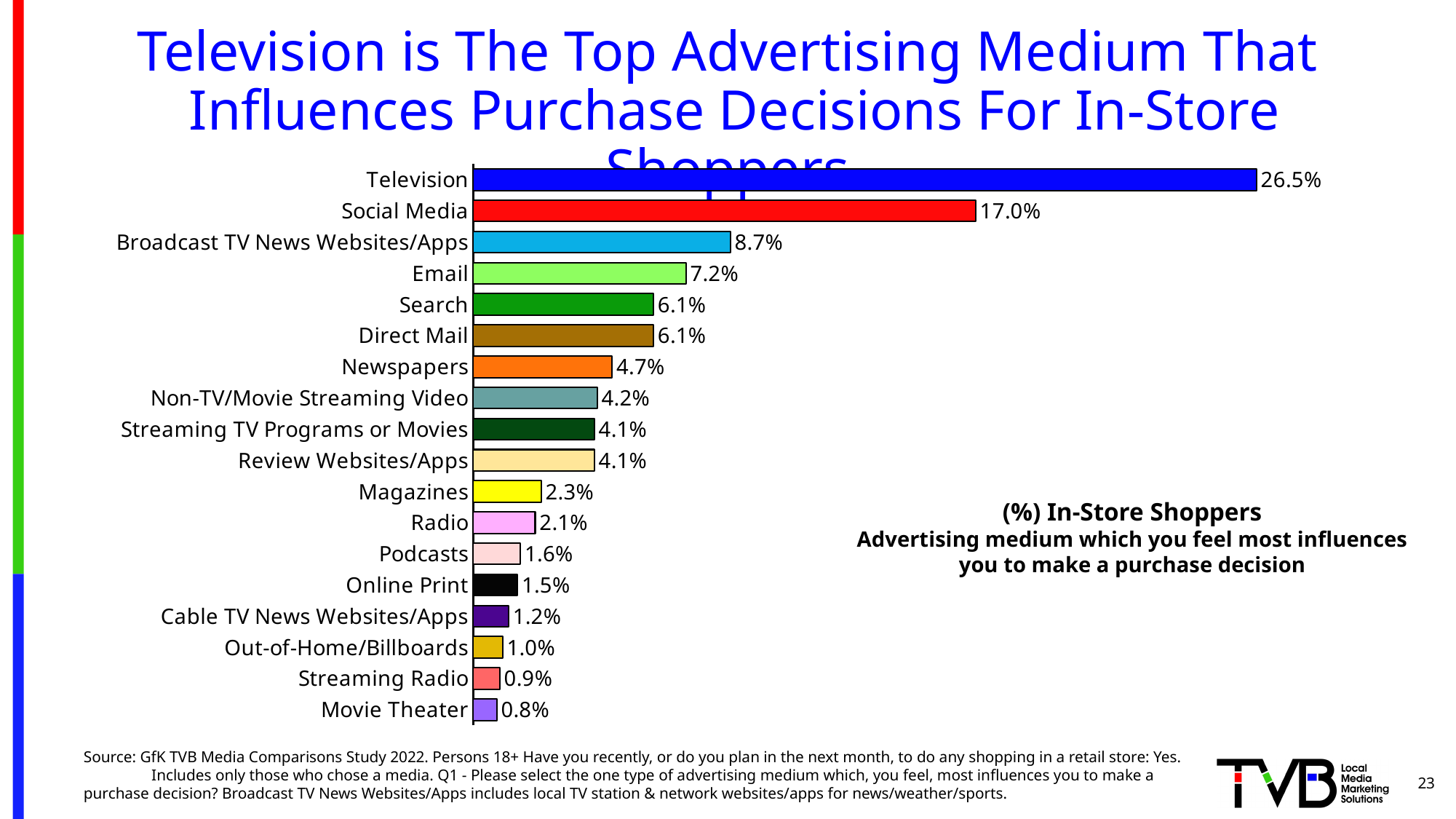
What is the value for Social Media? 17.0% What is the value for Television? 26.5% What is the difference between the values for Television and Social Media? 9.5% What is the difference between the values for Email and Magazines? 4.9% Which advertising medium has the lowest value? Movie Theater What kind of chart is shown on the slide? Bar chart Which advertising medium has the highest value? Television What colour is the bar for Social Media? Red How many advertising media are shown in the chart? 18 What is the value for Podcasts? 1.6% Which is larger, the value for Broadcast TV News Websites/Apps or the value for Email? Broadcast TV News Websites/Apps What is the value for Newspapers? 4.7%